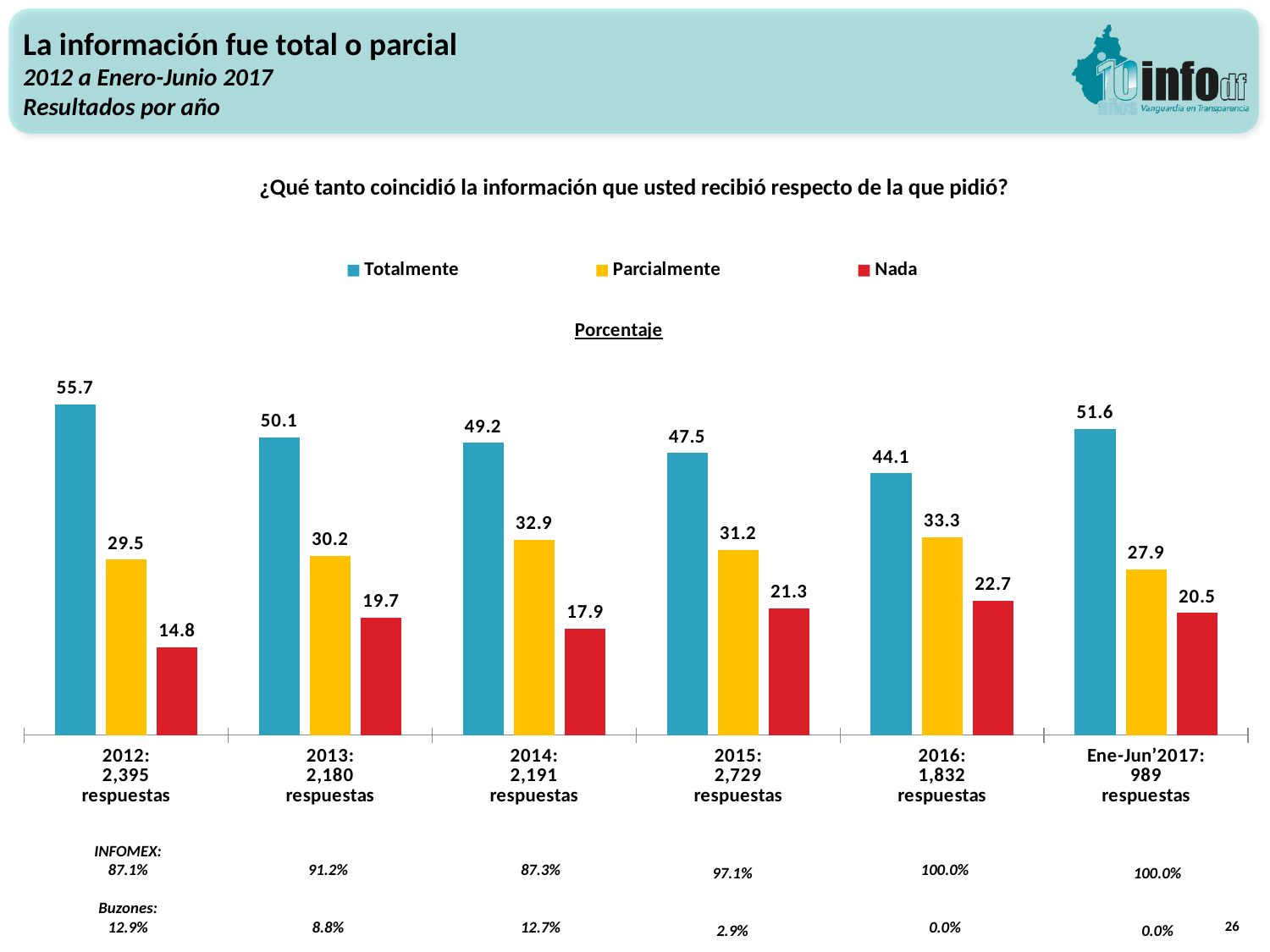
How many year categories are shown on the x axis? 6 Which year has the highest value for Totalmente? 2012 Which is larger, the Parcialmente value in 2014 or in 2013? 2014 Which year has the lowest value for Nada? 2012 Does the Totalmente value rise or fall from 2012 to 2016? fall How many series does the legend list? 3 What is the value for Totalmente in 2012? 55.7 What is the value for Parcialmente in 2016? 33.3 What is the difference between the Totalmente and Parcialmente values in 2015? 16.3 What is the value for Nada in Ene-Jun'2017? 20.5 Which colour represents the Nada series in the legend? red What kind of chart is shown on the slide? bar chart